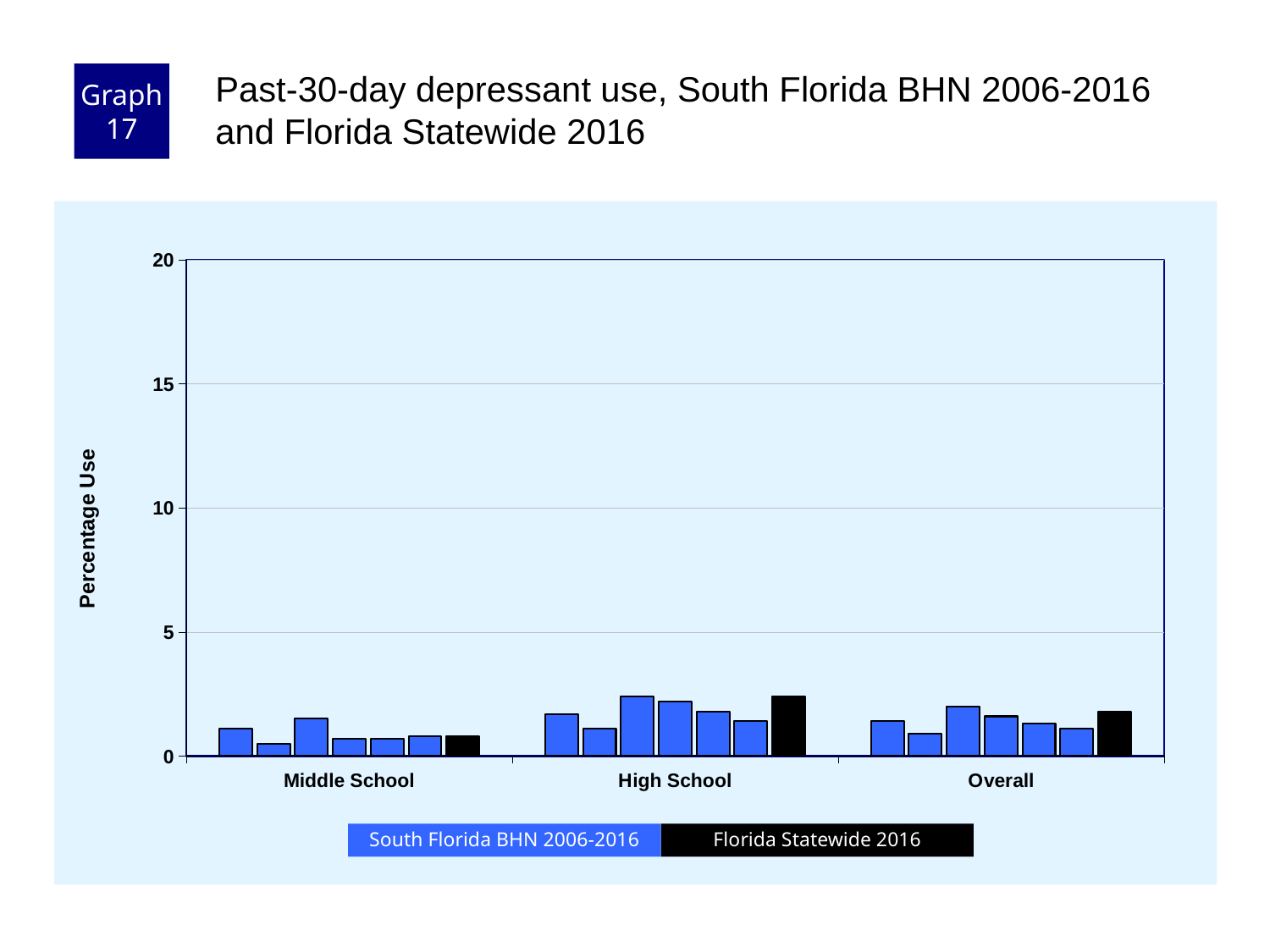
What is the title of the chart? Past-30-day depressant use, South Florida BHN 2006-2016 and Florida Statewide 2016 Is the Florida Statewide 2016 value for Middle School greater or less than 5? less How many school-level categories are shown on the x axis? 3 What kind of chart is shown on the slide? bar chart Which is larger, the Florida Statewide 2016 value for High School or for Middle School? High School What is the label on the y axis? Percentage Use Which is larger, the Florida Statewide 2016 value for Overall or for Middle School? Overall Is the Florida Statewide 2016 value for Overall greater or less than 10? less Which category has the highest Florida Statewide 2016 value? High School Is the Florida Statewide 2016 value for High School greater or less than 5? less How many series does the legend list? 2 Which category has the lowest Florida Statewide 2016 value? Middle School